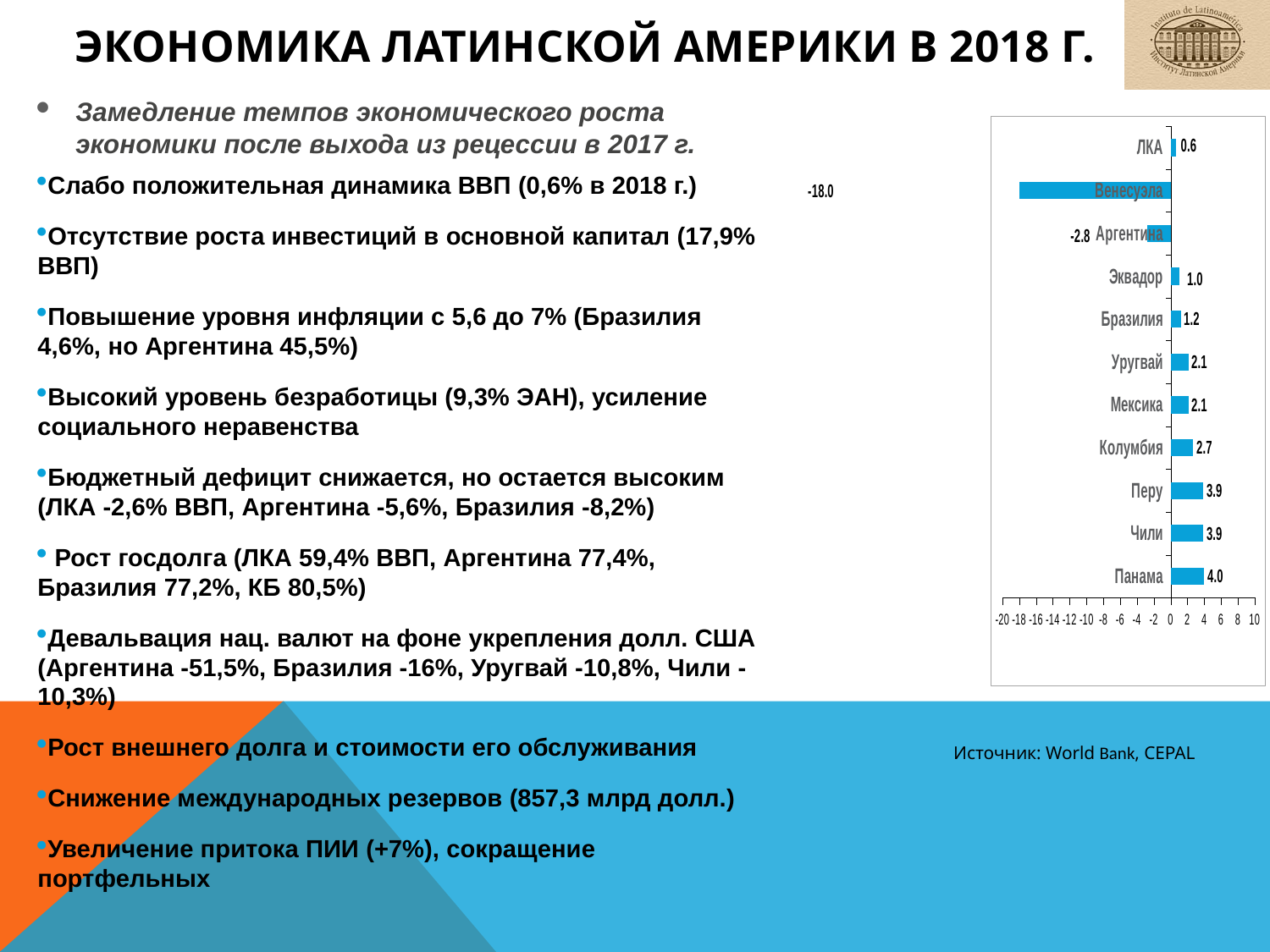
How many categories are shown in the bar chart? 11 What is the difference between the values for Панама and Венесуэла in the bar chart? 22.0 Which has a larger value in the bar chart, Перу or Уругвай? Перу What is the difference between the values for Колумбия and Бразилия in the bar chart? 1.5 Which category has the highest value in the bar chart? Панама What is the value shown for Венесуэла in the bar chart? -18.0 What is the value shown for Аргентина in the bar chart? -2.8 Which category has the lowest value in the bar chart? Венесуэла Is the value for Венесуэла in the bar chart greater or less than -10? less What is the value shown for ЛКА in the bar chart? 0.6 What is the value shown for Панама in the bar chart? 4.0 What kind of chart is shown on the right side of the slide? bar chart